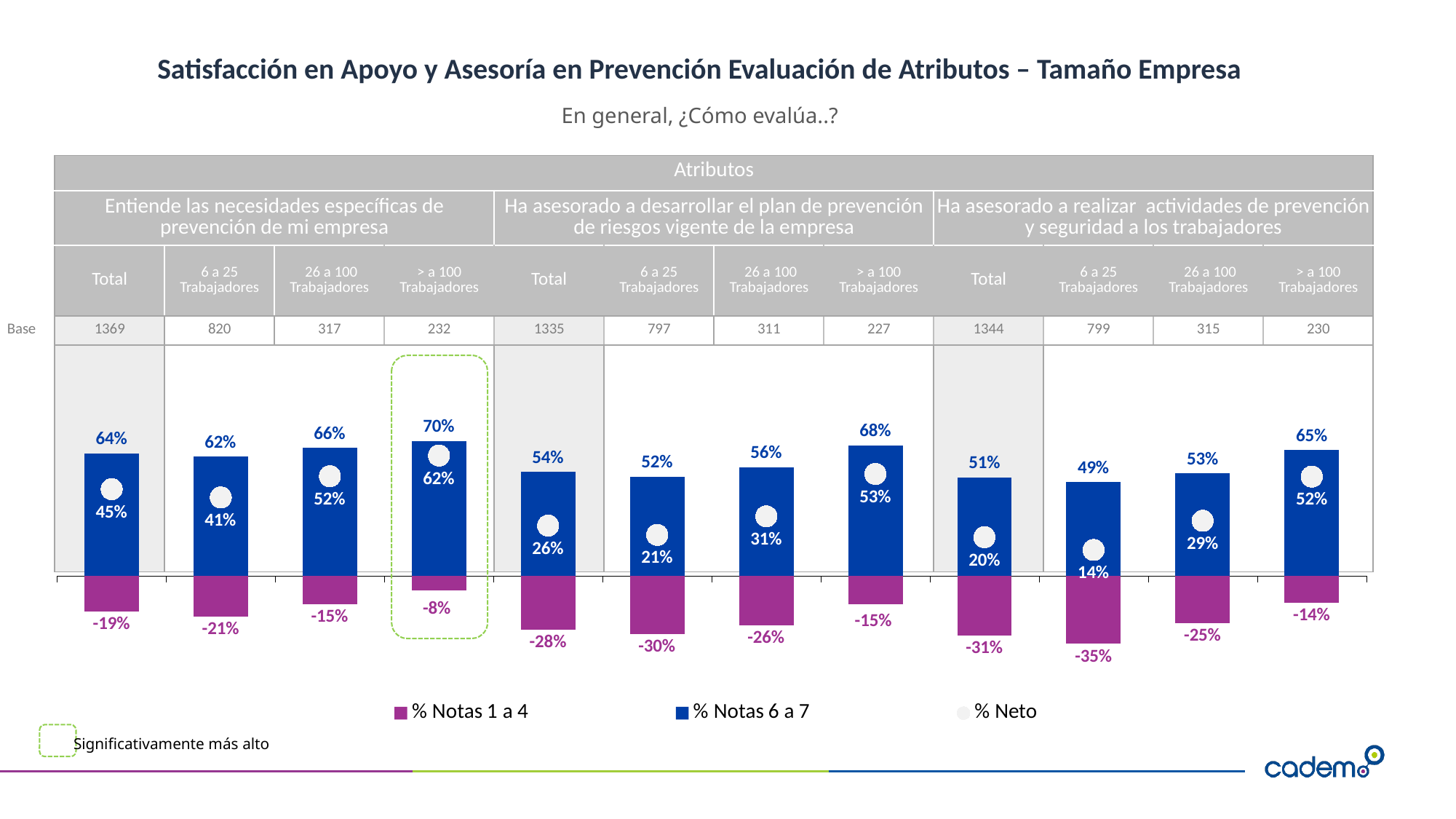
How many bars (categories) are plotted in the chart? 12 What is the % Notas 1 a 4 value for "6 a 25 Trabajadores" under "Ha asesorado a realizar actividades de prevención y seguridad a los trabajadores"? -35% How many series does the legend list? 3 What is the Base (sample size) for Total under "Ha asesorado a realizar actividades de prevención y seguridad a los trabajadores"? 1344 Which category has the highest % Notas 6 a 7 value across the whole chart? > a 100 Trabajadores (Entiende las necesidades específicas de prevención de mi empresa) What kind of chart is shown on the slide? Bar chart Which series is shown in purple in the legend? % Notas 1 a 4 What is the % Notas 6 a 7 value for Total under "Entiende las necesidades específicas de prevención de mi empresa"? 64% Which category has the lowest % Neto value across the whole chart? 6 a 25 Trabajadores (Ha asesorado a realizar actividades de prevención y seguridad a los trabajadores) Which is larger: the % Neto for "26 a 100 Trabajadores" under "Ha asesorado a desarrollar el plan de prevención" or the % Neto for "26 a 100 Trabajadores" under "Ha asesorado a realizar actividades de prevención y seguridad"? Ha asesorado a desarrollar el plan de prevención (31%) What is the % Neto value for "> a 100 Trabajadores" under "Entiende las necesidades específicas de prevención de mi empresa"? 62% What is the difference between the % Notas 6 a 7 values for Total and "> a 100 Trabajadores" under "Ha asesorado a desarrollar el plan de prevención de riesgos vigente de la empresa"? 14 percentage points